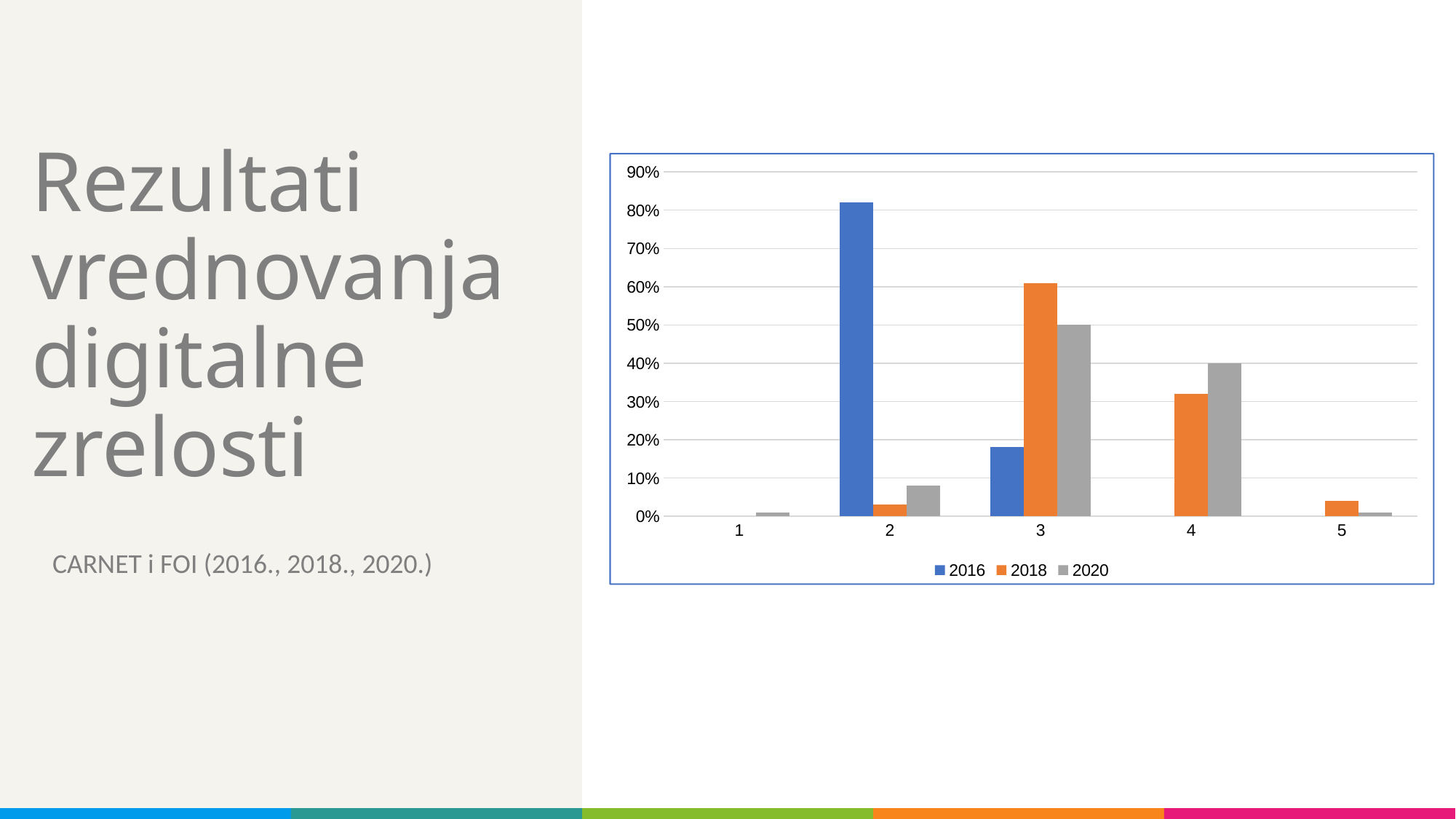
What kind of chart is shown on the slide? bar chart Is the value for 2016 in category 2 greater or less than 80%? greater In category 4, which series has the larger value, 2018 or 2020? 2020 How many series does the legend list? 3 Is the value for 2018 in category 3 greater or less than 50%? greater What entries are listed in the chart legend? 2016, 2018, 2020 How many categories are shown on the x axis? 5 What is the value for the 2020 series in category 4? 40% Which category has the highest value for the 2018 series? 3 Is the value for 2016 in category 3 greater or less than 20%? less In category 3, which series has the larger value, 2018 or 2020? 2018 Which category has the highest value for the 2016 series? 2